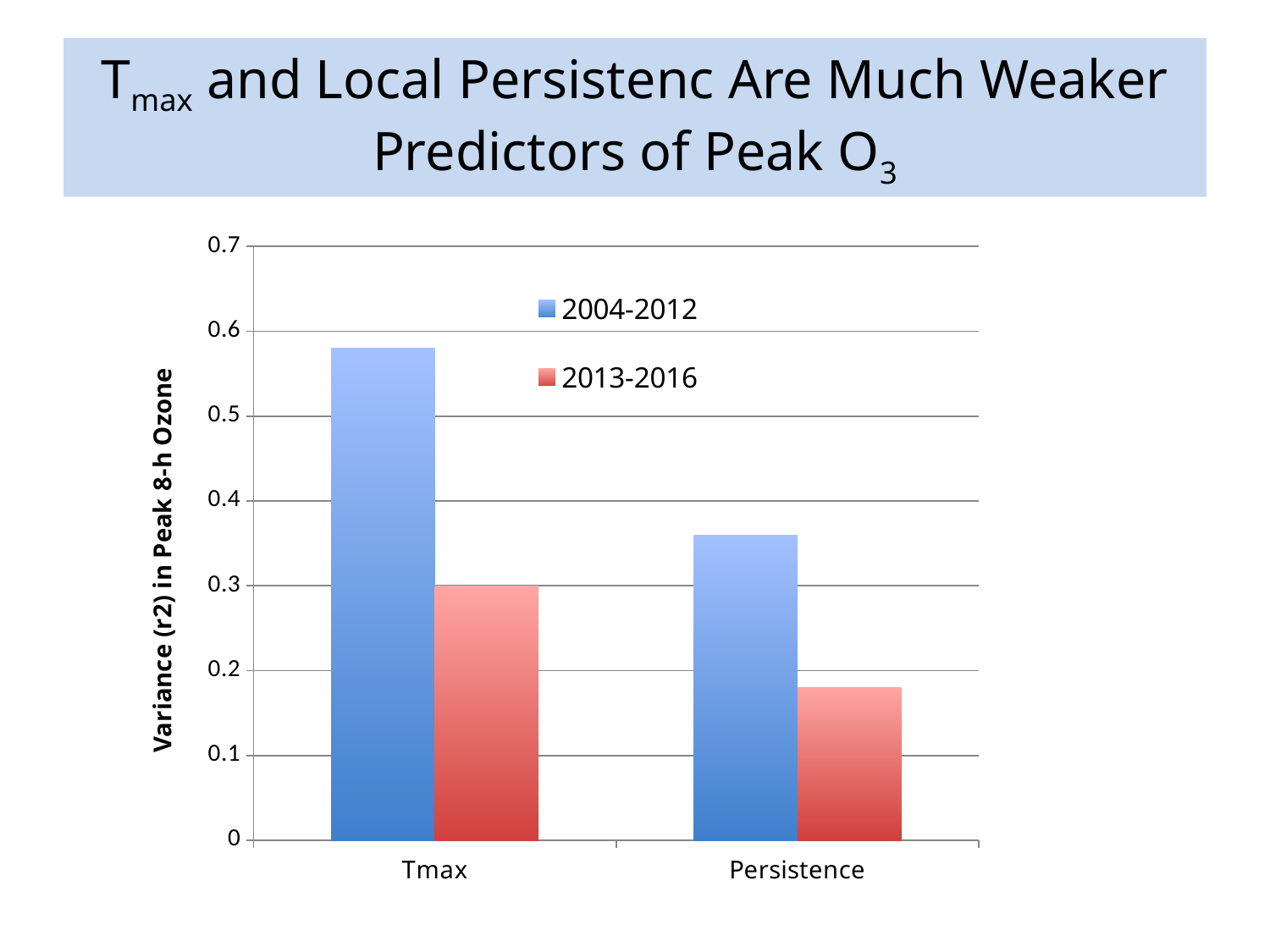
Which is larger: the 2013-2016 value for Tmax or the 2004-2012 value for Persistence? 2004-2012 value for Persistence For Persistence, which series has the larger value, 2004-2012 or 2013-2016? 2004-2012 What is the value for Tmax in the 2013-2016 series? 0.3 Which category has the highest value for the 2004-2012 series? Tmax How many categories are shown on the x axis? 2 What kind of chart is shown on the slide? bar chart Which category has the lowest value for the 2013-2016 series? Persistence How many series does the legend list? 2 Is the value for Persistence in the 2004-2012 series greater or less than 0.4? less Is the value for Persistence in the 2013-2016 series greater or less than 0.2? less Is the value for Tmax in the 2004-2012 series greater or less than 0.5? greater What is the label of the y axis? Variance (r2) in Peak 8-h Ozone